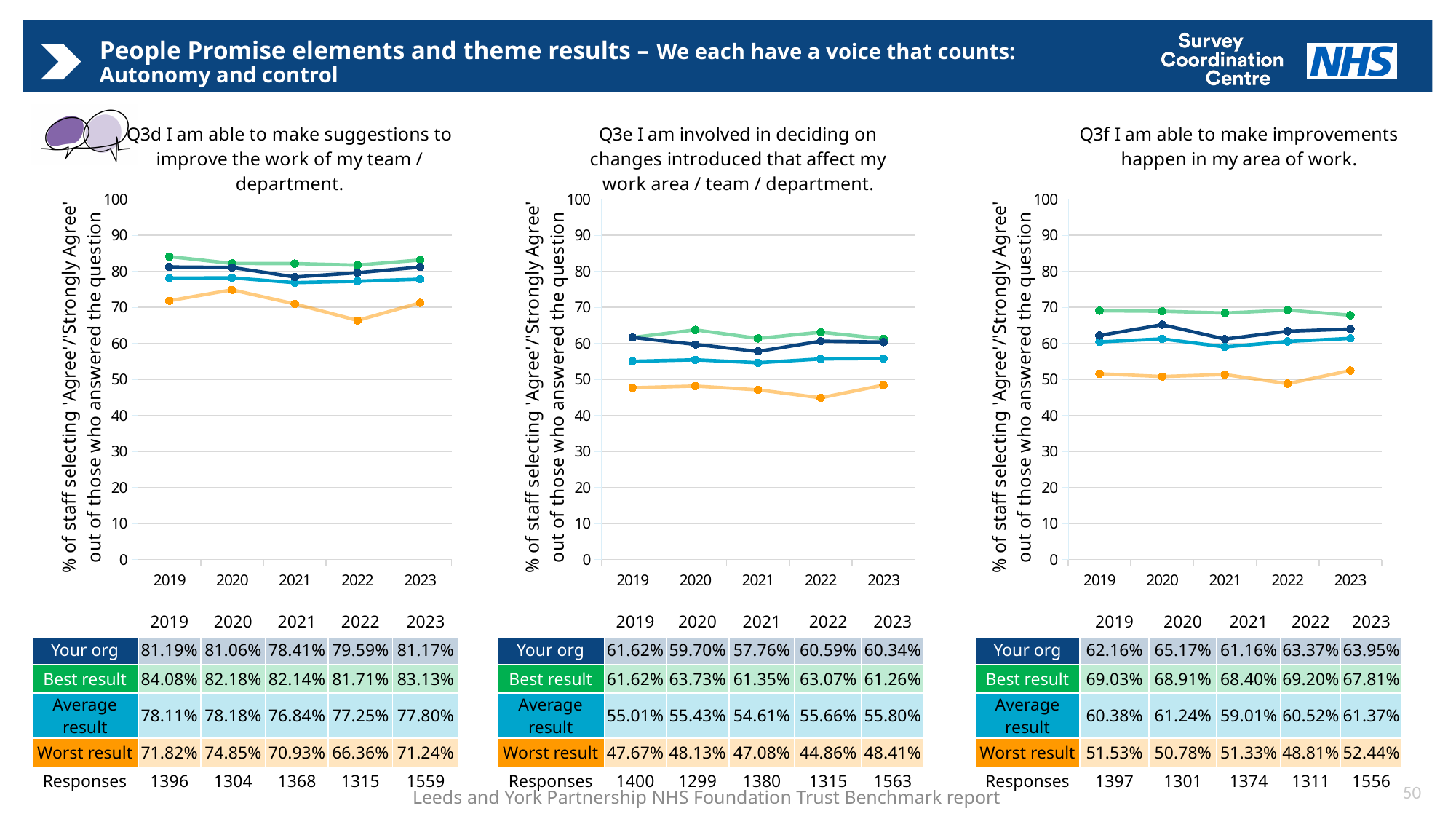
In the Q3f chart, is the 'Your org' value for 2022 larger or smaller than the 'Average result' value for 2022? larger In the Q3d chart, which year has the lowest 'Worst result' value? 2022 How many years are plotted on the x axis of the Q3d chart? 5 In the Q3f chart, what is the 'Average result' value for 2021? 59.01% How many series are plotted in the Q3e chart? 4 In the Q3e chart, is the 'Worst result' value for 2019 greater or less than 50? less In the Q3e chart, what is the difference between the 'Best result' and 'Your org' values for 2020? 4.03% In the Q3f chart, which year has the highest 'Your org' value? 2020 What type of chart is used for Q3f? Line chart In the Q3d chart, what is the 'Your org' value for 2023? 81.17% In the Q3e chart, what is the 'Worst result' value for 2022? 44.86% In the Q3d chart, how many responses were recorded for 2023? 1559